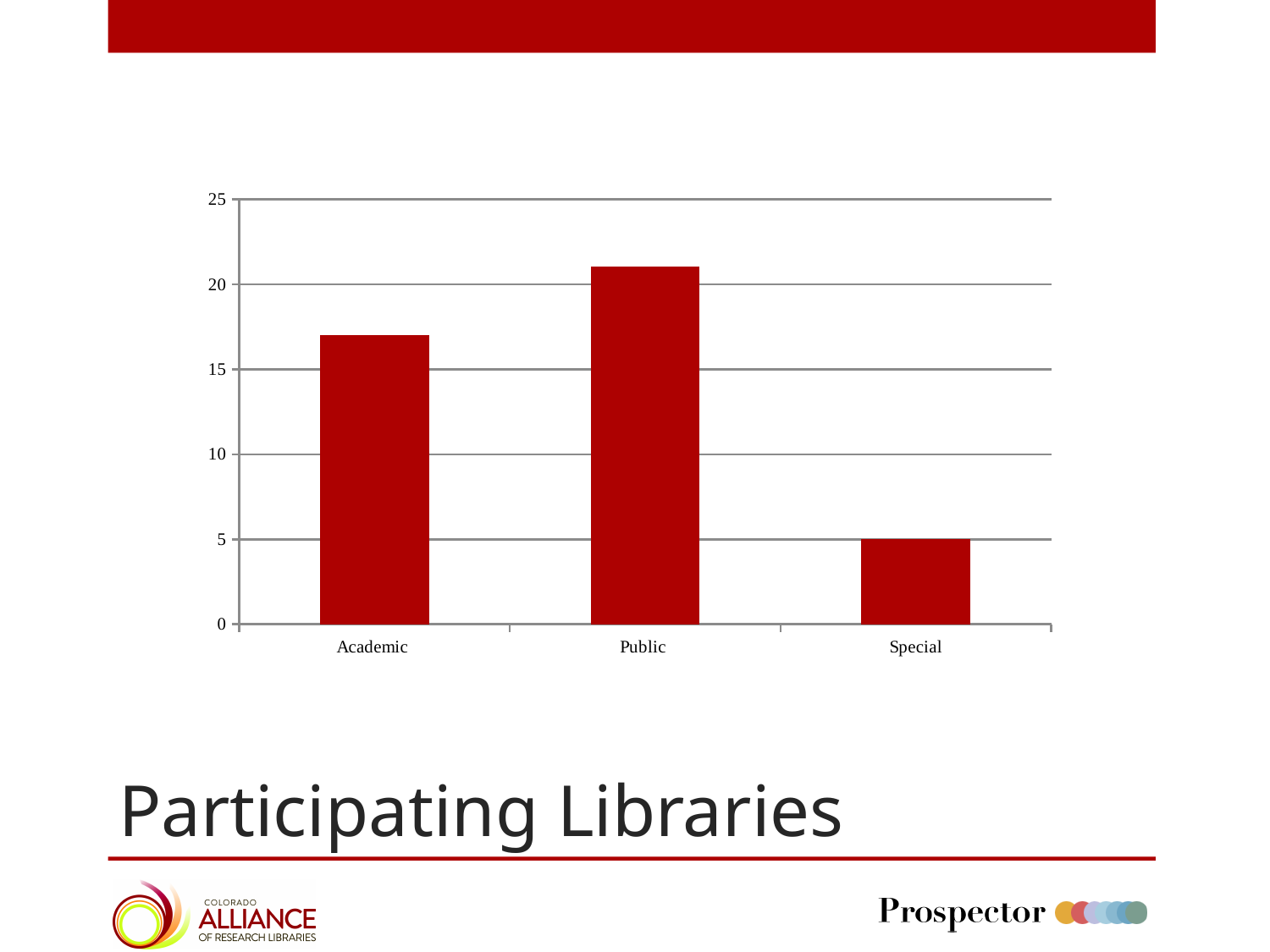
What kind of chart is shown on the slide? bar chart Is the value for Public greater or less than 20? greater How many categories are shown on the x axis of the chart? 3 Is the value for Public greater or less than 25? less Which is larger, the value for Academic or the value for Public? Public Which is larger, the value for Academic or the value for Special? Academic Is the value for Academic greater or less than 15? greater Which category has the highest bar in the chart? Public What is the title shown on the slide for this chart? Participating Libraries What is the value for Special in the chart? 5 Which category has the lowest bar in the chart? Special